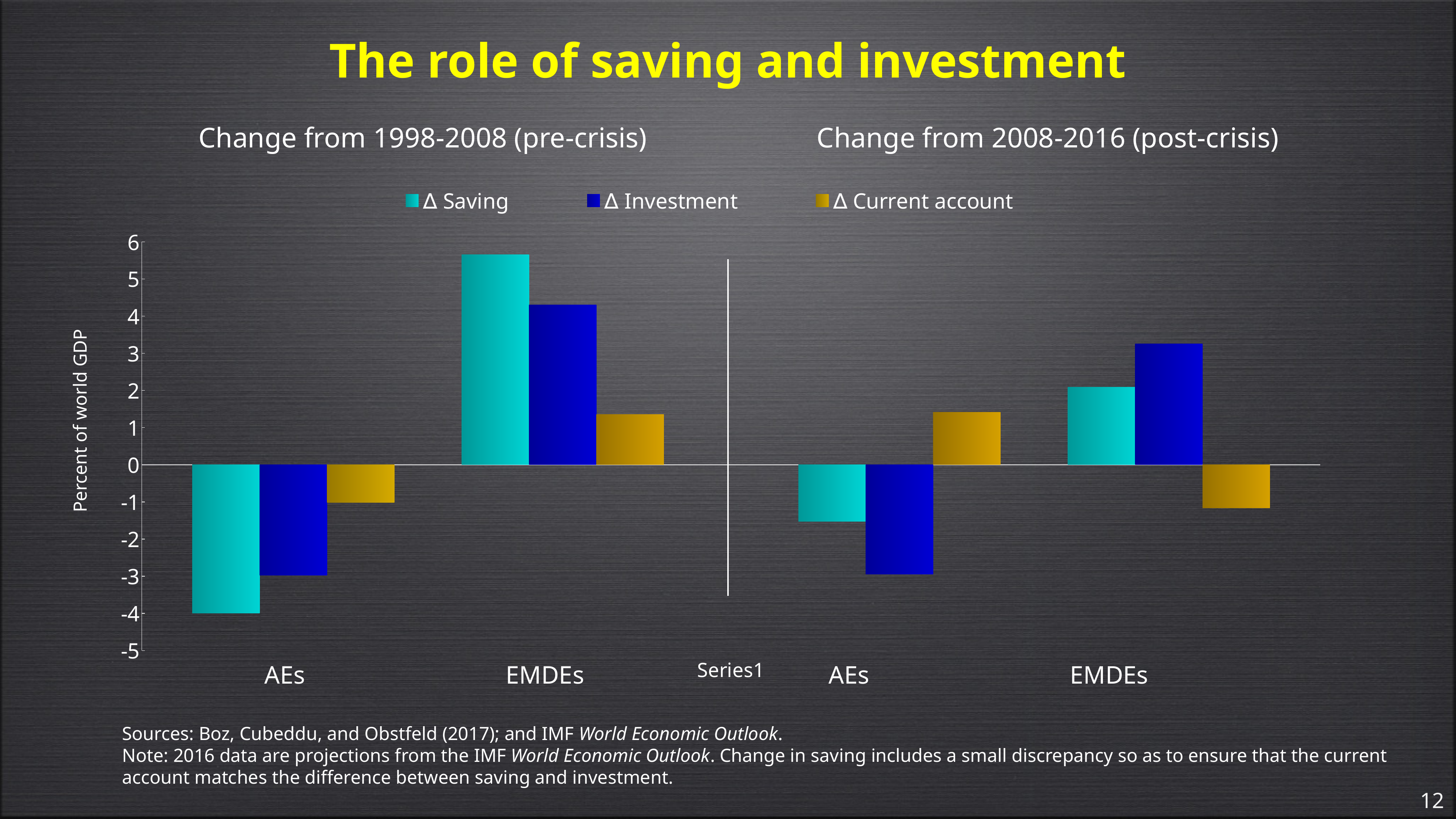
What kind of chart is shown on the slide? bar chart In the pre-crisis panel (Change from 1998-2008), is the Δ Saving value for AEs greater or less than -3? less In the post-crisis panel (Change from 2008-2016), is the Δ Investment value for EMDEs greater or less than 2? greater In the pre-crisis panel (Change from 1998-2008), which is larger for EMDEs: Δ Saving or Δ Investment? Δ Saving In the post-crisis panel (Change from 2008-2016), is the Δ Investment value for AEs greater or less than -2? less How many series does the legend list? 3 Which legend entry is shown in dark blue? Δ Investment What is the label of the vertical axis? Percent of world GDP Which bar on the whole chart reaches the highest value? Δ Saving for EMDEs in the pre-crisis panel In the post-crisis panel (Change from 2008-2016), which is larger for EMDEs: Δ Saving or Δ Investment? Δ Investment